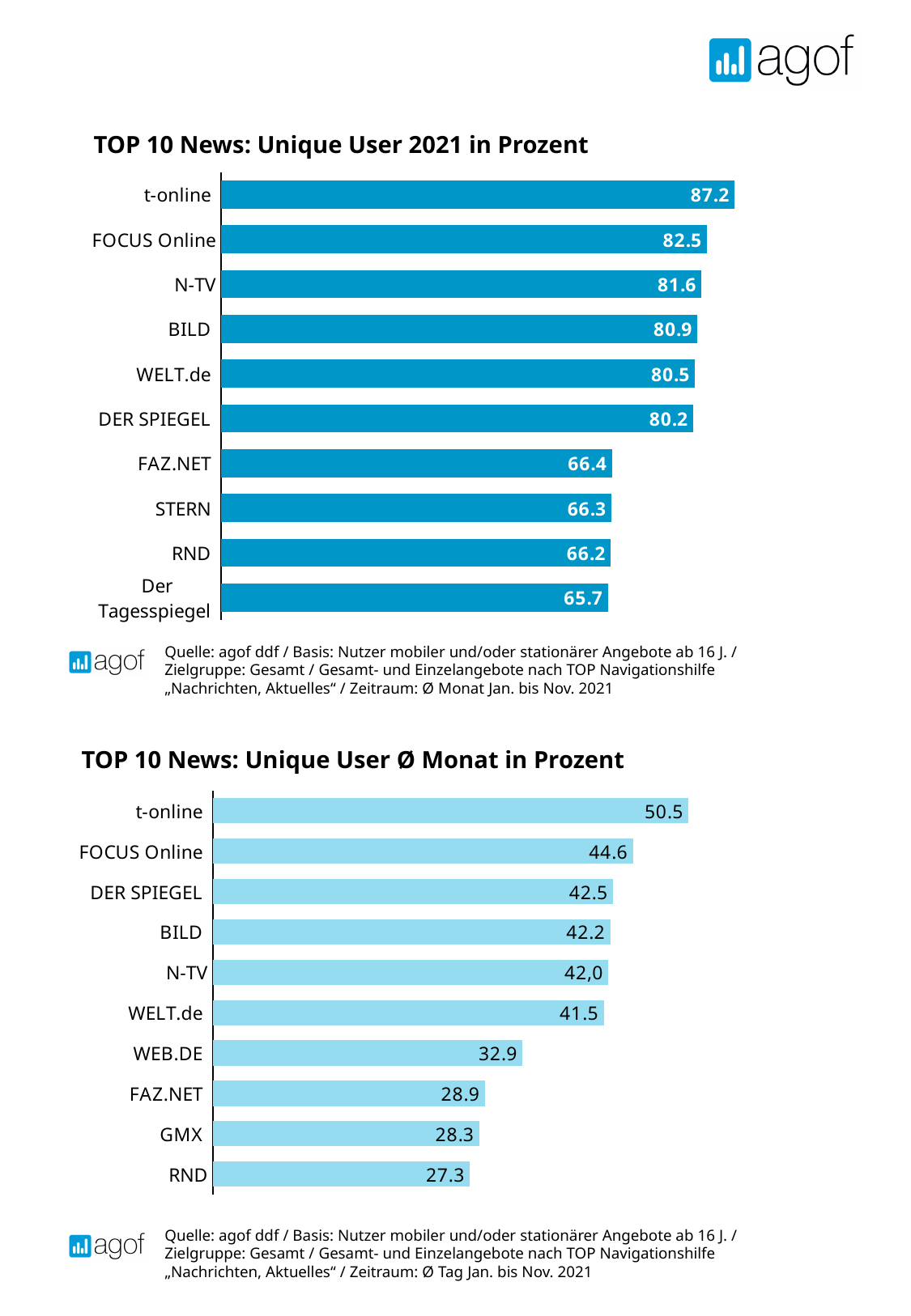
In the chart 'TOP 10 News: Unique User 2021 in Prozent', which category has the lowest value? Der Tagesspiegel In the chart 'TOP 10 News: Unique User Ø Monat in Prozent', what is the difference between t-online and RND? 23.2 In the chart 'TOP 10 News: Unique User Ø Monat in Prozent', which is larger, GMX or FAZ.NET? FAZ.NET In the chart 'TOP 10 News: Unique User Ø Monat in Prozent', what is the value for N-TV? 42,0 In the chart 'TOP 10 News: Unique User 2021 in Prozent', which is larger, BILD or FAZ.NET? BILD In the chart 'TOP 10 News: Unique User 2021 in Prozent', what is the difference between FOCUS Online and N-TV? 0.9 In the chart 'TOP 10 News: Unique User 2021 in Prozent', what is the value for t-online? 87.2 In the chart 'TOP 10 News: Unique User Ø Monat in Prozent', which category has the highest value? t-online In the chart 'TOP 10 News: Unique User Ø Monat in Prozent', what is the value for WEB.DE? 32.9 In the chart 'TOP 10 News: Unique User 2021 in Prozent', what is the value for DER SPIEGEL? 80.2 What kind of chart is 'TOP 10 News: Unique User Ø Monat in Prozent'? Bar chart In the chart 'TOP 10 News: Unique User 2021 in Prozent', how many categories are shown? 10